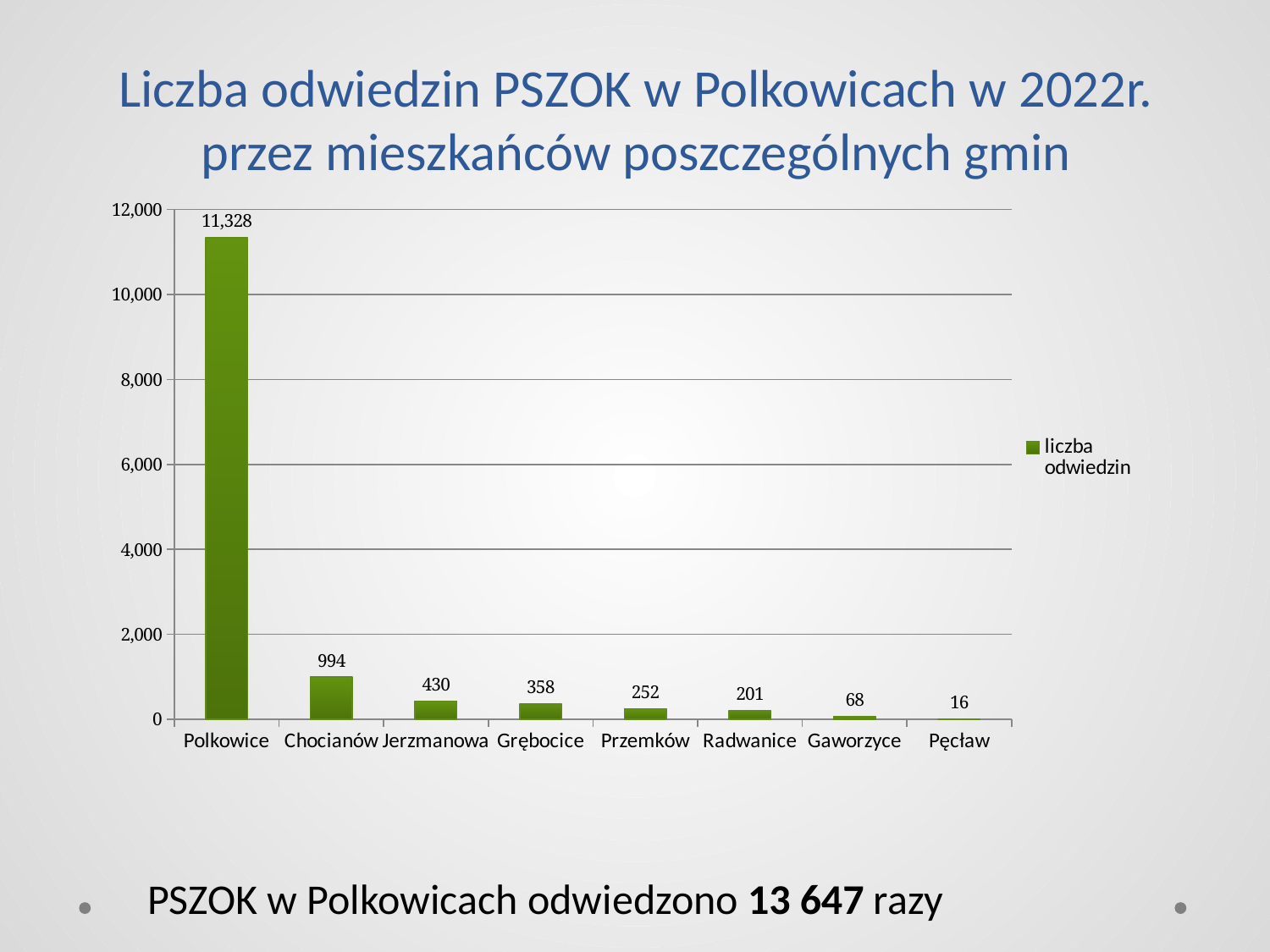
How many municipalities are shown on the x axis? 8 What is the legend entry for the series? liczba odwiedzin What is the number of visits for Gaworzyce? 68 Which has more visits, Radwanice or Gaworzyce? Radwanice Is the value for Polkowice greater or less than 10,000? greater Which municipality has the highest number of visits? Polkowice What is the number of visits for Grębocice? 358 How many series does the legend list? 1 What is the difference in visits between Jerzmanowa and Przemków? 178 Which municipality has the lowest number of visits? Pęcław What kind of chart is shown on the slide? bar chart What is the number of visits for Chocianów? 994